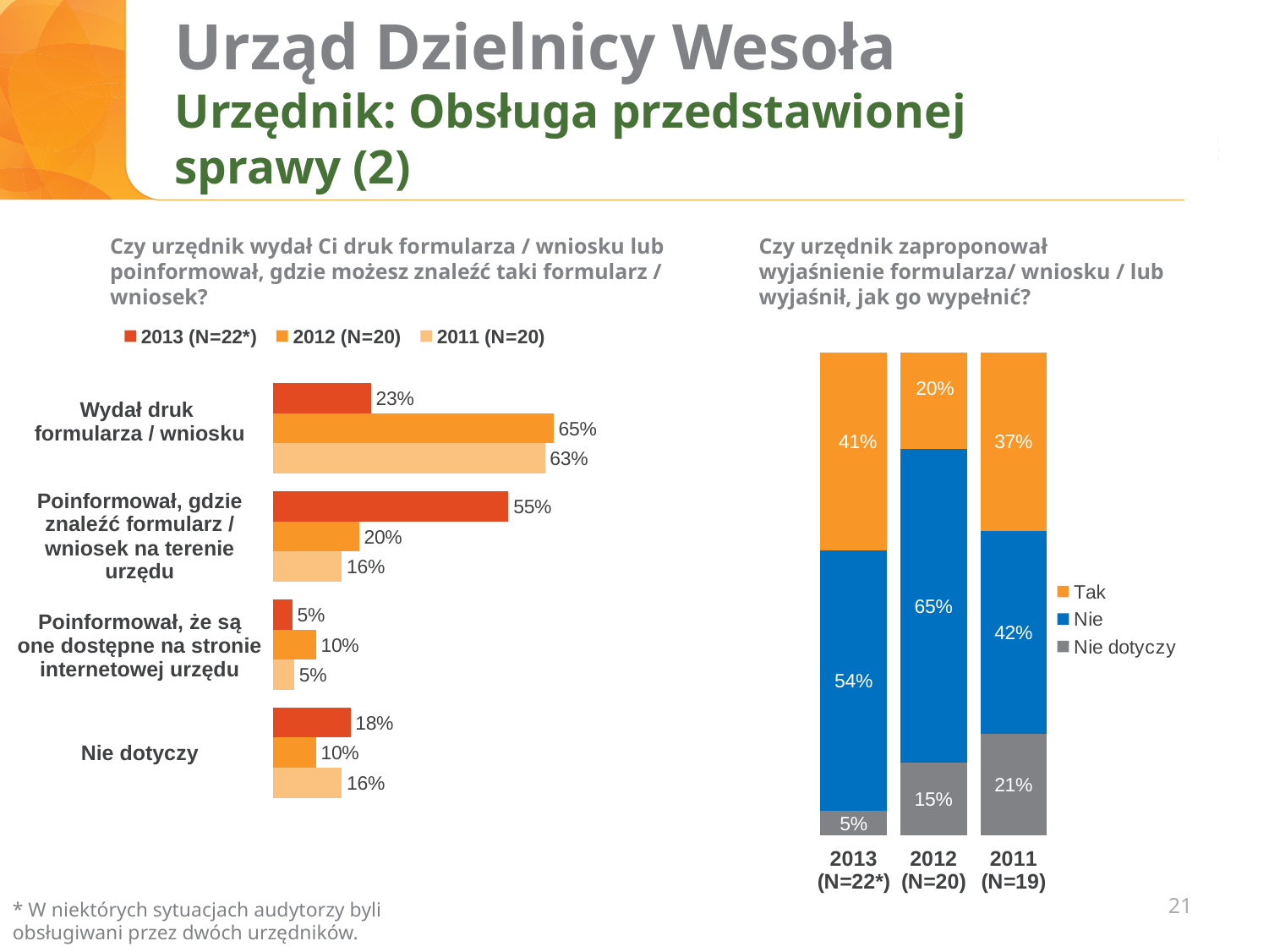
In the left chart, what is the 2013 (N=22*) value for 'Wydał druk formularza / wniosku'? 23% In the left chart, what is the 2012 (N=20) value for 'Poinformował, gdzie znaleźć formularz / wniosek na terenie urzędu'? 20% In the right chart, what is the 'Nie dotyczy' value for 2011 (N=19)? 21% In the left chart, how many series does the legend list? 3 In the left chart, what is the difference between the 2012 and 2013 values for 'Wydał druk formularza / wniosku'? 42 percentage points What kind of chart is the left chart? Bar chart In the right chart, which year has the highest 'Tak' value? 2013 (N=22*) In the left chart, which category has the highest 2013 (N=22*) value? Poinformował, gdzie znaleźć formularz / wniosek na terenie urzędu In the right chart, what is the total of the 2012 (N=20) stacked bar? 100% In the right chart, what is the 'Nie' value for 2012 (N=20)? 65% In the left chart, how many categories are shown? 4 In the right chart, is the 'Nie' value for 2013 (N=22*) larger or smaller than the 'Nie' value for 2011 (N=19)? Larger